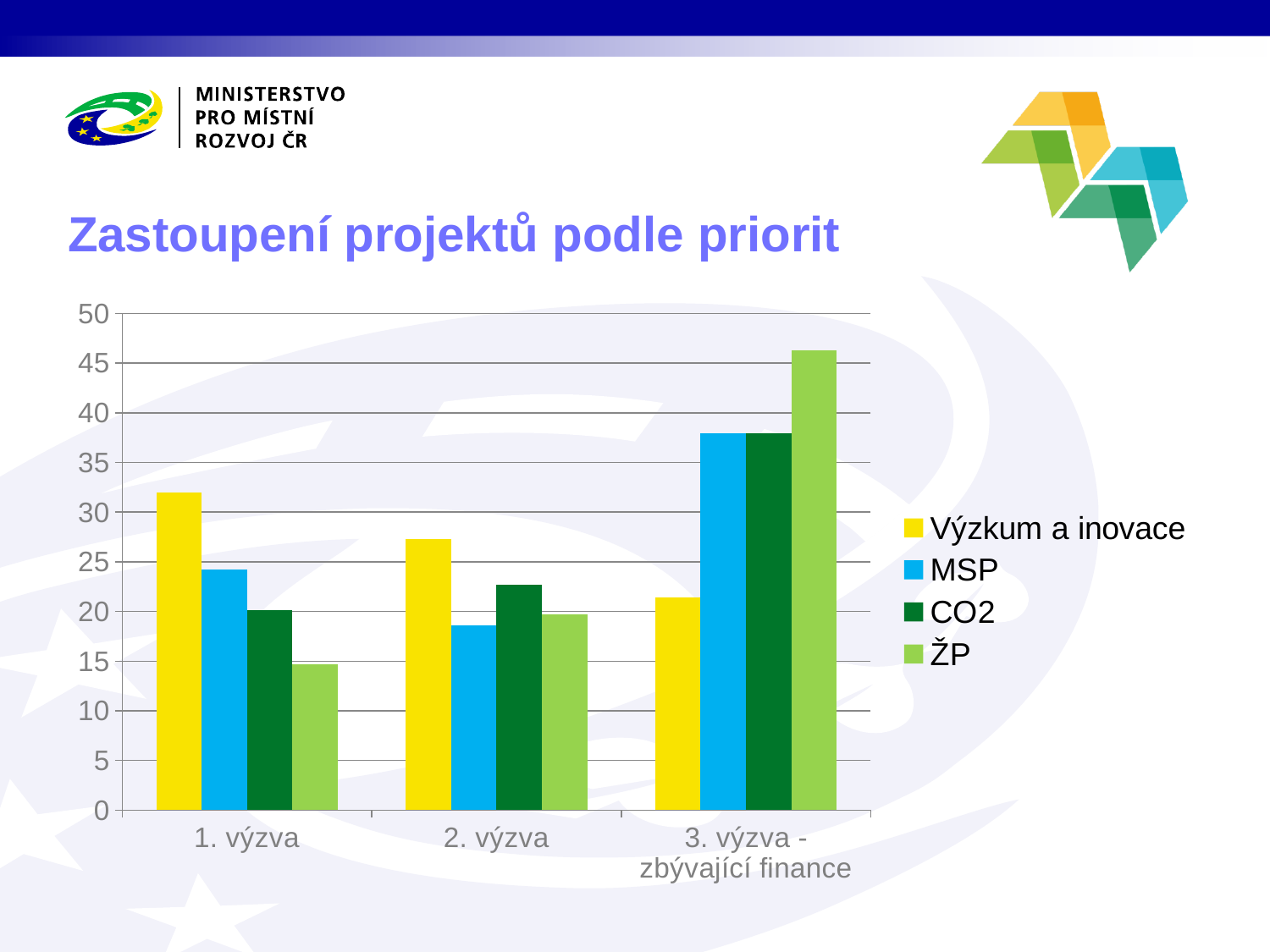
Which is larger: Výzkum a inovace in '1. výzva' or Výzkum a inovace in '2. výzva'? Výzkum a inovace in '1. výzva' Is the value for ŽP in '3. výzva - zbývající finance' greater or less than 45? greater Which series is shown in yellow in the legend? Výzkum a inovace What is the title of the slide's chart? Zastoupení projektů podle priorit Which series has the highest value in the category '1. výzva'? Výzkum a inovace Which series has the lowest value in the category '1. výzva'? ŽP How many series does the legend list? 4 What kind of chart is shown on the slide? bar chart Which series has the lowest value in the category '2. výzva'? MSP Which series has the highest value in the category '3. výzva - zbývající finance'? ŽP How many categories are shown on the x axis? 3